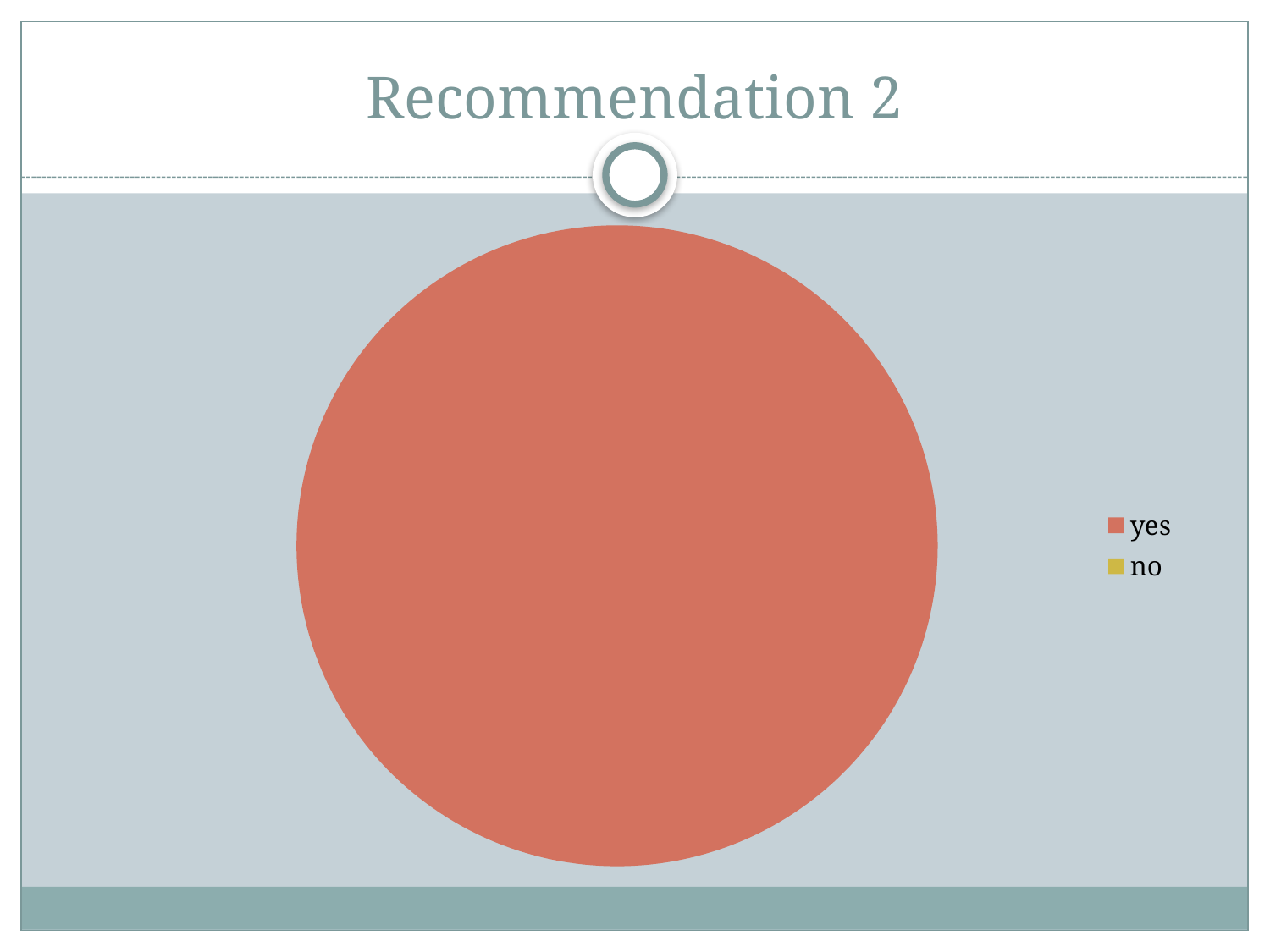
What is the title of the slide containing the pie chart? Recommendation 2 Which category takes up the smallest share of the pie chart? no Which category has the larger share of the pie, yes or no? yes What kind of chart is shown on the slide? pie chart Which category takes up the largest share of the pie chart? yes What colour represents the 'yes' category in the pie chart? red/orange How many categories does the legend of the pie chart list? 2